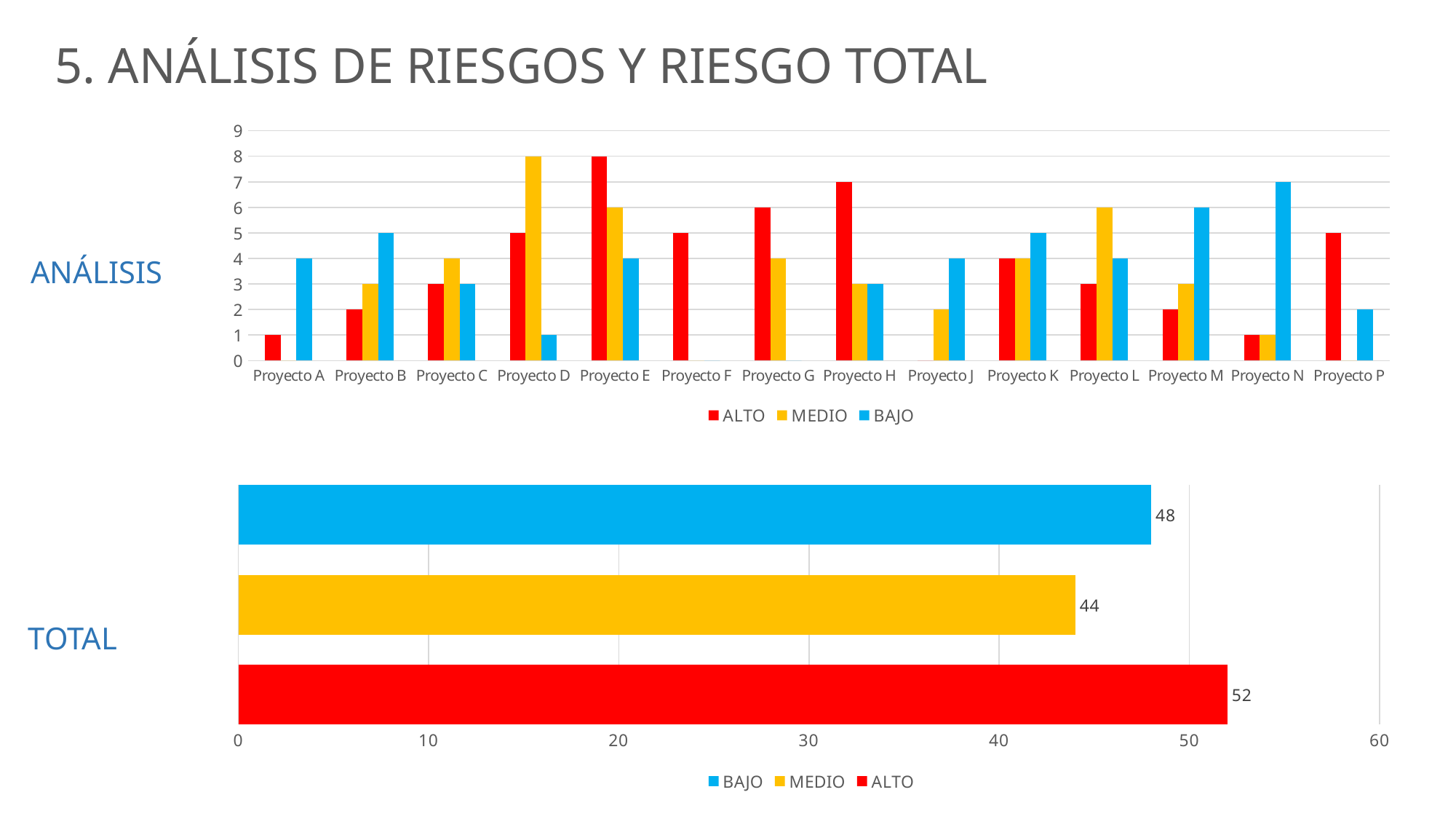
In the TOTAL chart, what is the difference between ALTO and MEDIO? 8 In the ANÁLISIS chart, which colour represents the MEDIO series? Yellow In the ANÁLISIS chart, how many projects are shown on the x axis? 14 In the TOTAL chart, what is the value for MEDIO? 44 In the TOTAL chart, which category has the highest value? ALTO In the ANÁLISIS chart, which is larger for Proyecto N: BAJO or ALTO? BAJO In the TOTAL chart, is the value for BAJO greater or less than 40? greater What kind of chart is the TOTAL chart? Bar chart In the ANÁLISIS chart, how many series does the legend list? 3 In the TOTAL chart, what is the value for ALTO? 52 In the ANÁLISIS chart, what is the ALTO value for Proyecto E? 8 In the TOTAL chart, which category has the lowest value? MEDIO